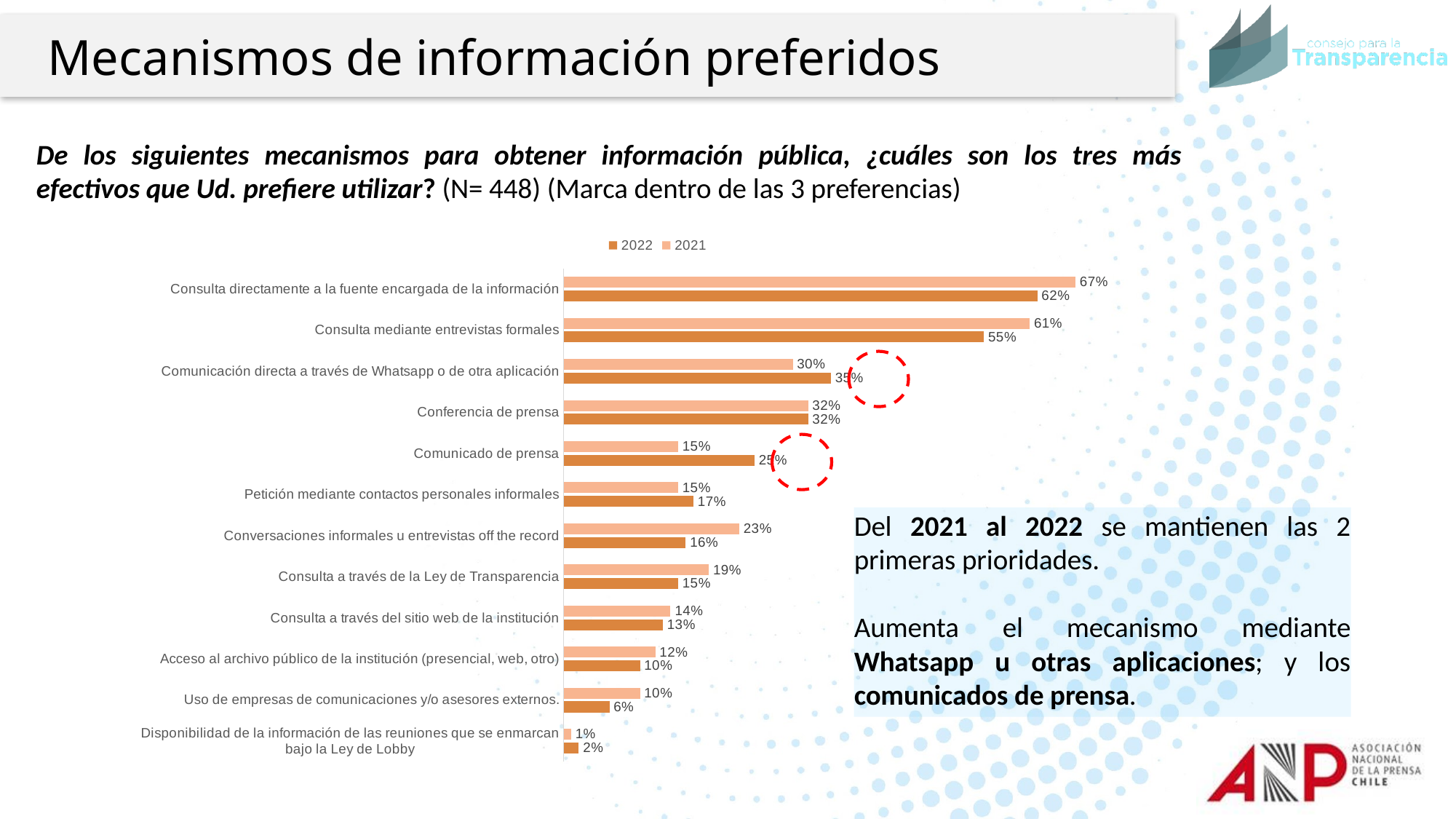
What is the 2022 value for 'Comunicado de prensa'? 25% Which series is shown in the darker orange colour? 2022 What is the difference between the 2022 and 2021 values for 'Comunicado de prensa'? 10% How many categories (mechanisms) are plotted in the chart? 12 For 'Conversaciones informales u entrevistas off the record', which year has the larger value, 2021 or 2022? 2021 What is the 2021 value for 'Consulta directamente a la fuente encargada de la información'? 67% Which category has the lowest 2021 value? Disponibilidad de la información de las reuniones que se enmarcan bajo la Ley de Lobby What kind of chart is shown on the slide? bar chart Which category has the highest 2022 value? Consulta directamente a la fuente encargada de la información How many series does the legend list? 2 What is the 2022 value for 'Comunicación directa a través de Whatsapp o de otra aplicación'? 35% What is the difference between the 2021 and 2022 values for 'Consulta mediante entrevistas formales'? 6%